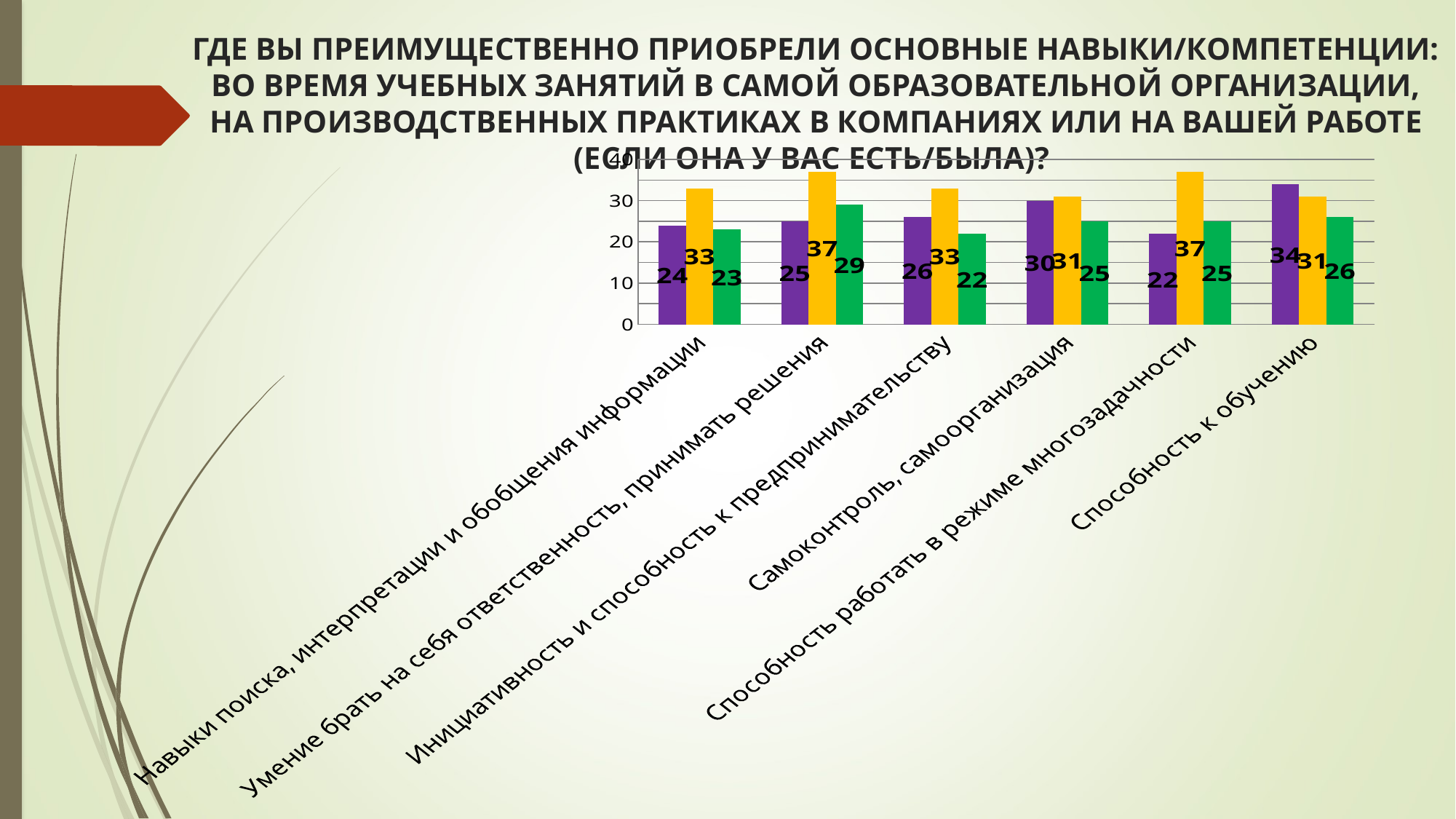
How many categories are shown on the x axis? 6 What kind of chart is shown on the slide? bar chart What is the value of the yellow bar for "Умение брать на себя ответственность, принимать решения"? 37 Is the yellow bar for "Навыки поиска, интерпретации и обобщения информации" greater or less than 30? greater What is the value of the purple bar for "Способность работать в режиме многозадачности"? 22 What is the value of the purple bar for "Способность к обучению"? 34 How many bars are shown for each category? 3 Which category has the highest purple bar? Способность к обучению What is the difference between the yellow and purple bars for "Способность работать в режиме многозадачности"? 15 For "Самоконтроль, самоорганизация", which is larger: the purple bar or the green bar? the purple bar What is the value of the green bar for "Инициативность и способность к предпринимательству"? 22 Which category has the lowest green bar? Инициативность и способность к предпринимательству